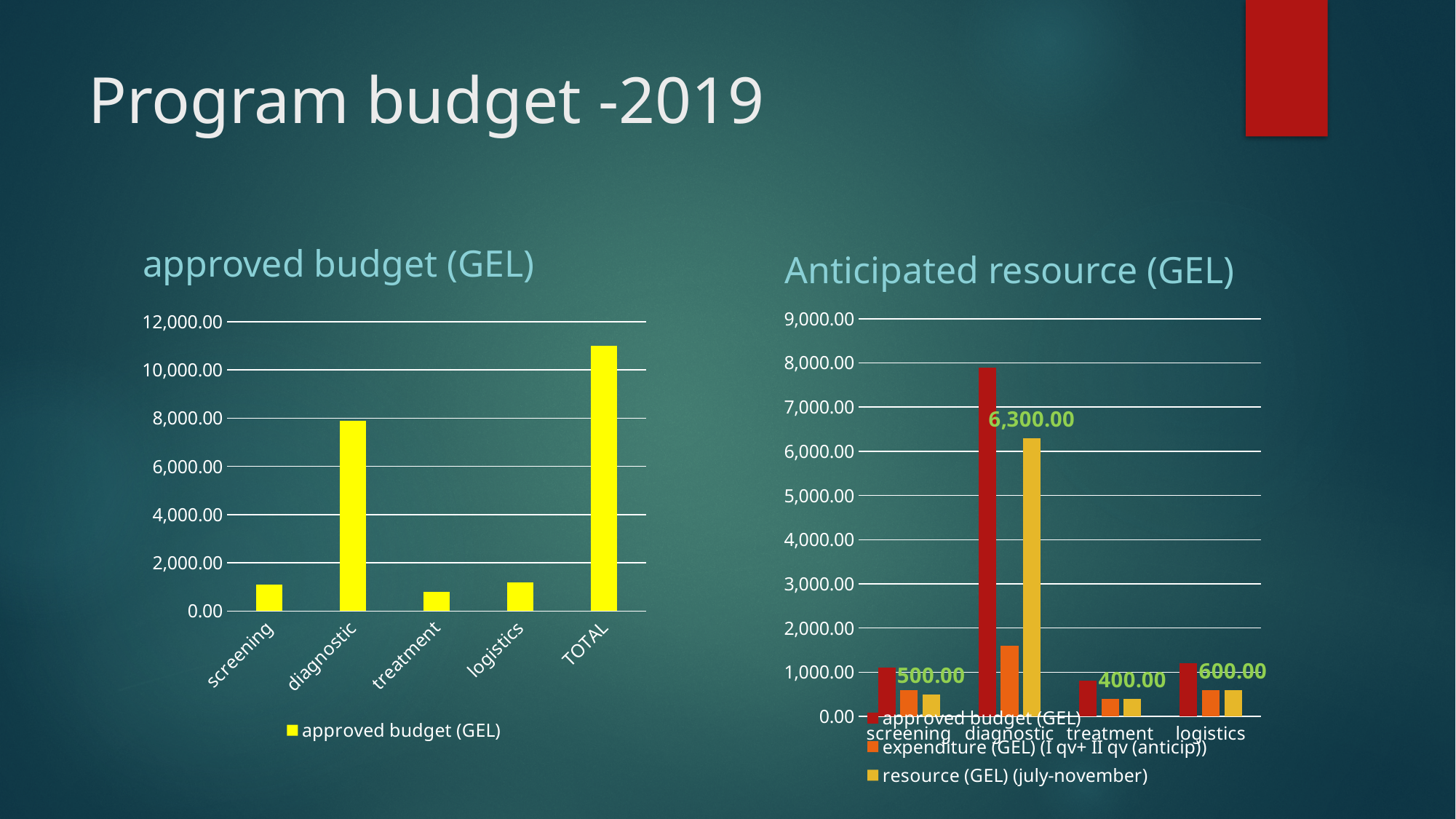
In the 'Anticipated resource (GEL)' chart on the right, what is the labelled value of 'resource (GEL) (july-november)' for diagnostic? 6,300.00 In the 'Anticipated resource (GEL)' chart on the right, for diagnostic, which is larger: the 'approved budget (GEL)' bar or the 'resource (GEL) (july-november)' bar? approved budget (GEL) In the 'approved budget (GEL)' chart on the left, which category has the highest bar? TOTAL How many categories are shown on the x axis of the 'approved budget (GEL)' chart on the left? 5 In the 'Anticipated resource (GEL)' chart on the right, what is the labelled value of 'resource (GEL) (july-november)' for screening? 500.00 How many categories are shown on the x axis of the 'Anticipated resource (GEL)' chart on the right? 4 In the 'Anticipated resource (GEL)' chart on the right, what is the difference between the 'resource (GEL) (july-november)' values for diagnostic and treatment? 5,900.00 In the 'approved budget (GEL)' chart on the left, is the value for TOTAL greater or less than 10,000.00? greater In the 'approved budget (GEL)' chart on the left, which category has the lowest bar? treatment How many series does the legend of the 'Anticipated resource (GEL)' chart on the right list? 3 In the 'approved budget (GEL)' chart on the left, is the value for diagnostic greater or less than 6,000.00? greater What kind of chart is the 'approved budget (GEL)' chart on the left? bar chart